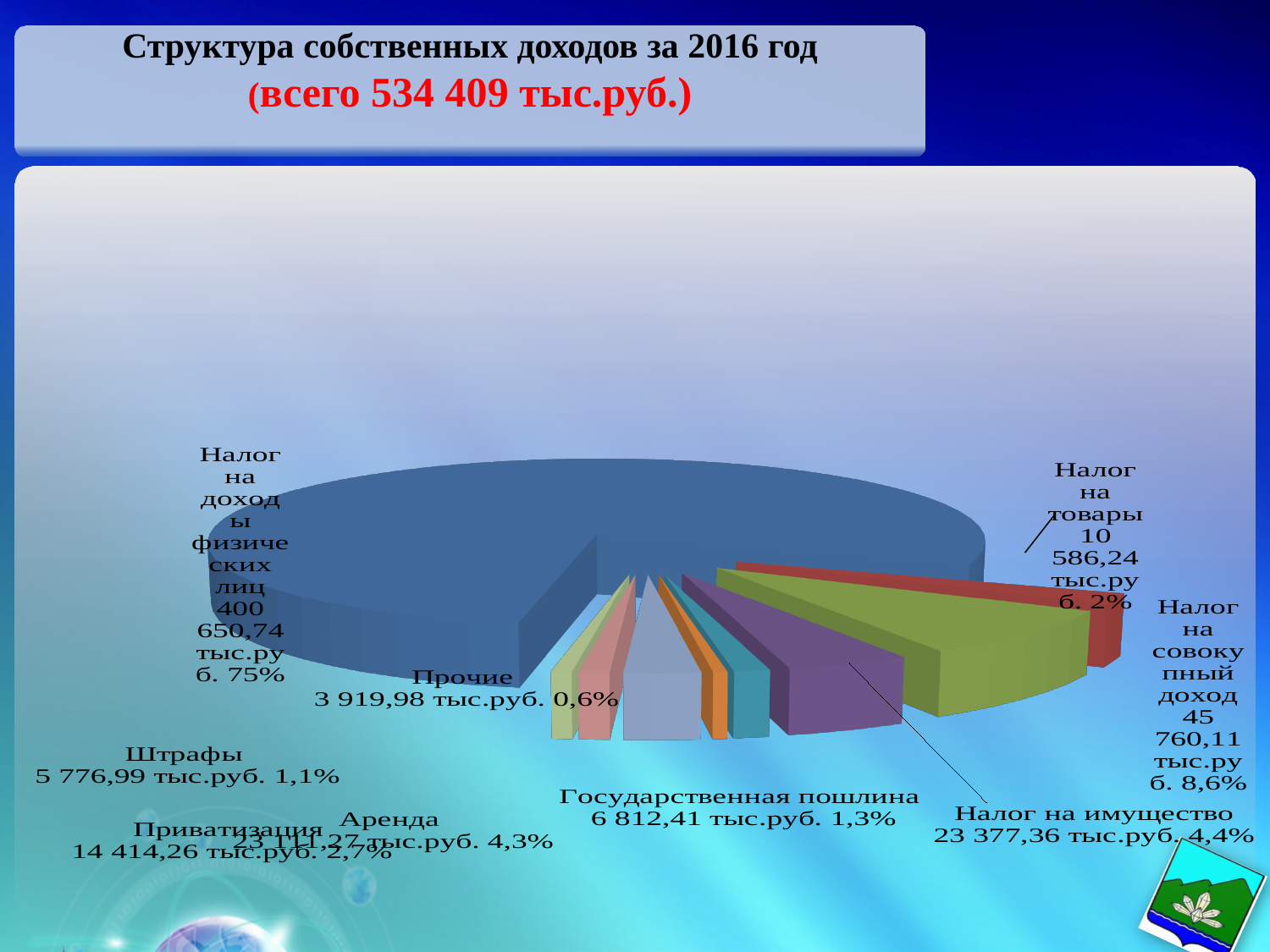
Which category has the smallest slice of the pie? Прочие What is the value for Налог на доходы физических лиц? 400 650,74 тыс.руб. What total amount is stated in the chart title? 534 409 тыс.руб. What is the difference between the values for Налог на имущество and Государственная пошлина? 16 564,95 тыс.руб. What kind of chart is shown on the slide? pie chart What is the value for Налог на совокупный доход? 45 760,11 тыс.руб. What share of the pie does Налог на имущество represent? 4,4% What share of the pie does Приватизация represent? 2,7% How many categories (slices) does the pie chart show? 9 Which category has the largest slice of the pie? Налог на доходы физических лиц Which is larger, Штрафы or Налог на товары? Налог на товары What is the value for Государственная пошлина? 6 812,41 тыс.руб.